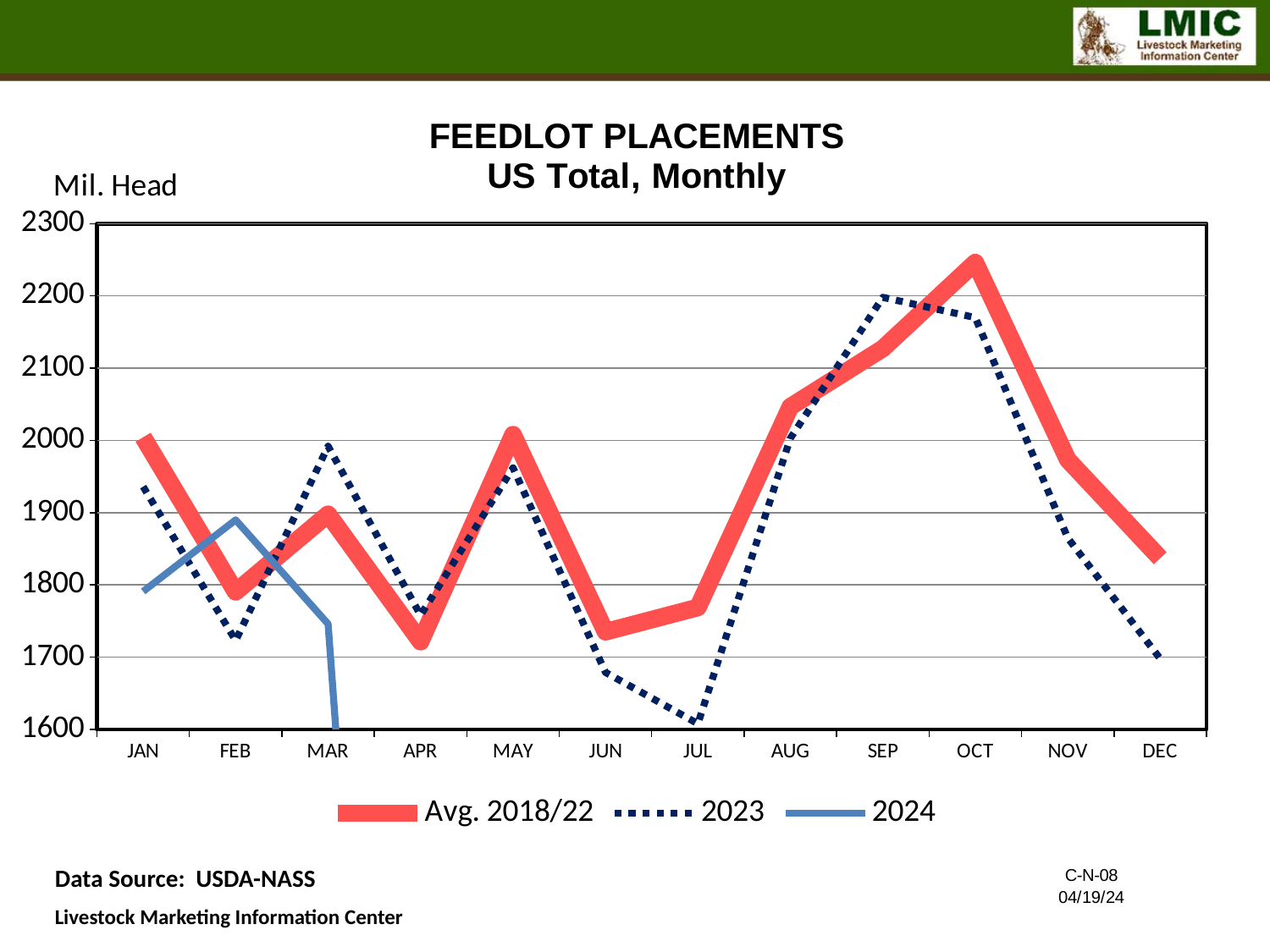
In which month does the Avg. 2018/22 series reach its lowest value? APR How many months are shown along the x axis? 12 Is the 2023 value for JUL greater or less than 1700? less What is the title of the chart? FEEDLOT PLACEMENTS US Total, Monthly In which month does the 2023 series reach its lowest value? JUL Is the Avg. 2018/22 value for OCT greater or less than 2200? greater What kind of chart is shown on the slide? line chart In which month does the Avg. 2018/22 series reach its highest value? OCT In SEP, which series has the larger value, Avg. 2018/22 or 2023? 2023 Does the 2024 series rise or fall from FEB to MAR? fall Is the 2024 value for FEB greater or less than 1800? greater How many series does the legend list? 3